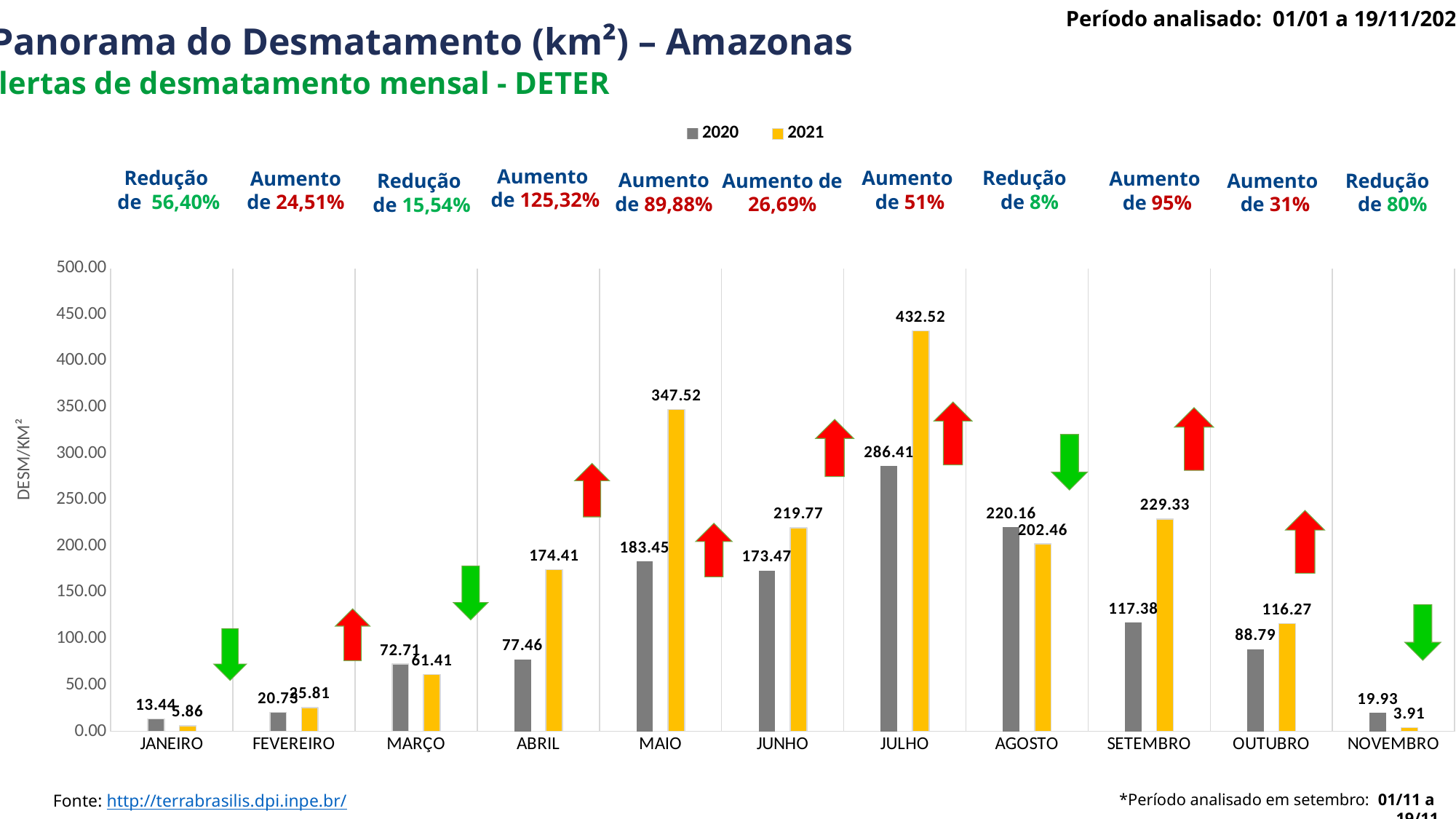
What kind of chart is shown on the slide? bar chart Which month has the lowest 2021 value? NOVEMBRO What is the difference between the 2021 and 2020 values for SETEMBRO? 111.95 What is the difference between the 2021 and 2020 values for JULHO? 146.11 What is the label of the y axis? DESM/KM² Is the 2021 value for MAIO greater or less than 300? greater For AGOSTO, which series has the larger value, 2020 or 2021? 2020 How many series does the legend list? 2 What is the 2021 value for JULHO? 432.52 Which month has the highest 2021 value? JULHO How many months are shown on the x axis? 11 What is the 2020 value for MAIO? 183.45